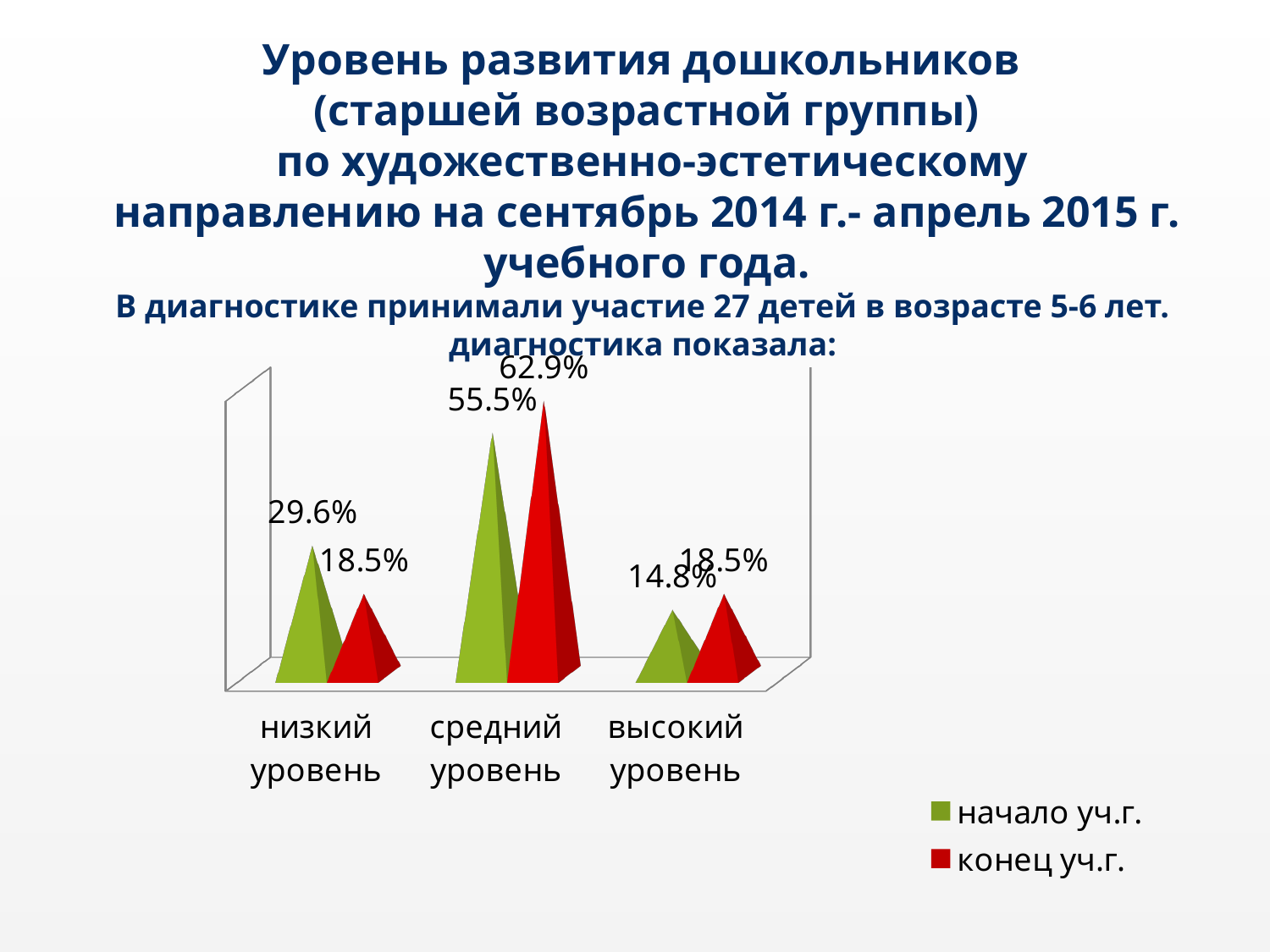
What colour represents the "конец уч.г." series? red How many series does the legend list? 2 What is the value for "низкий уровень" in the "начало уч.г." series? 29.6% Which category has the highest value in the "конец уч.г." series? средний уровень For "низкий уровень", which series has the larger value: "начало уч.г." or "конец уч.г."? начало уч.г. What is the value for "средний уровень" in the "конец уч.г." series? 62.9% How many categories are shown on the x axis? 3 What is the difference between the "конец уч.г." and "начало уч.г." values for "средний уровень"? 7.4% Which category has the lowest value in the "начало уч.г." series? высокий уровень What kind of chart is shown on the slide? bar chart What is the value for "высокий уровень" in the "начало уч.г." series? 14.8% What is the value for "низкий уровень" in the "конец уч.г." series? 18.5%